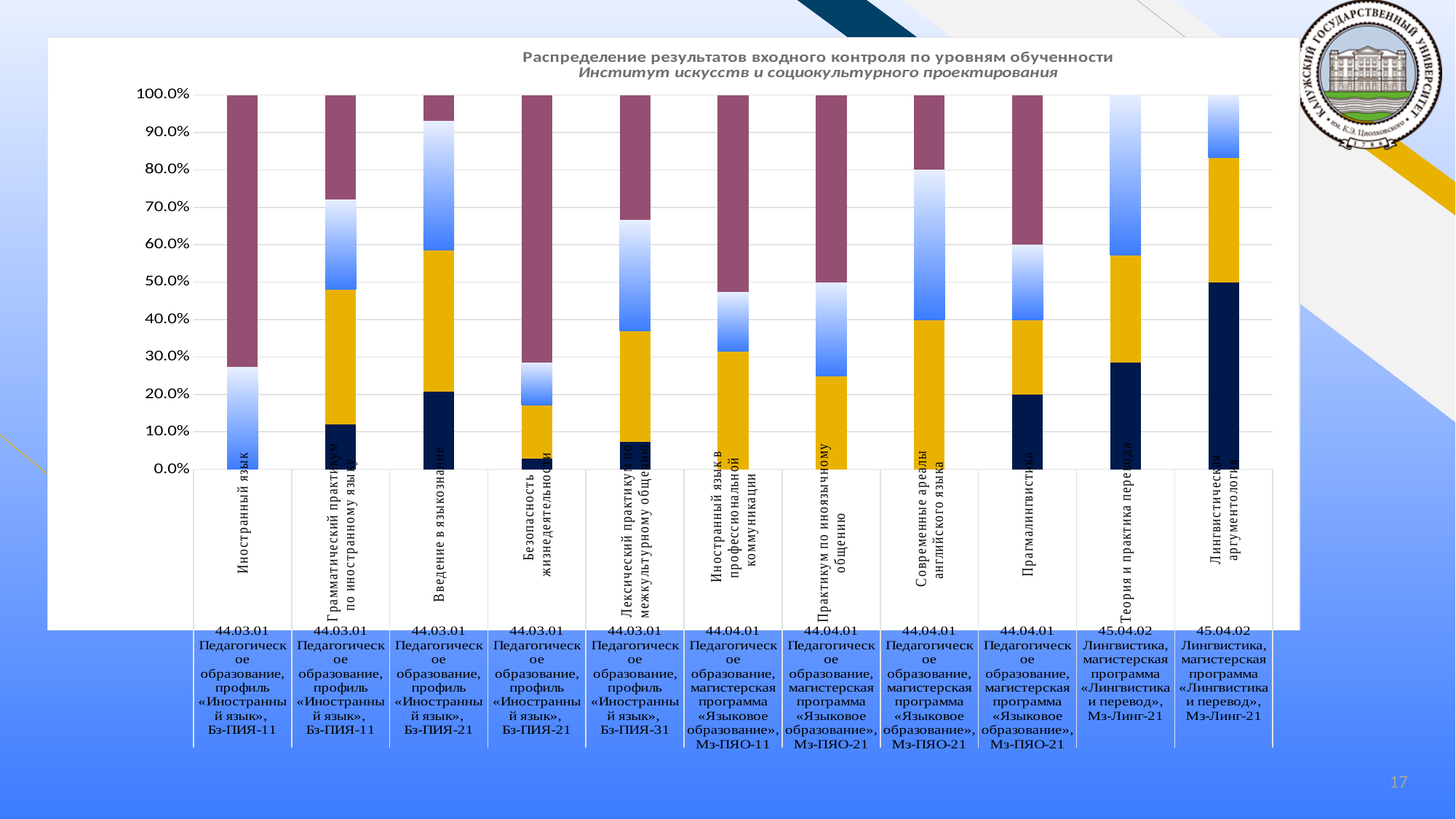
Which discipline has the largest dark navy (bottom) segment? Лингвистическая аргументология How many bars (disciplines) are plotted in the chart? 11 In the bar for Введение в языкознание, is the top of the yellow segment greater or less than 50%? greater Is the dark navy (bottom) segment of the bar for Теория и практика перевода greater or less than 20%? greater What kind of chart is shown on the slide? Stacked bar chart Which bar has the larger purple segment: Безопасность жизнедеятельности or Прагмалингвистика? Безопасность жизнедеятельности Which institute is named in the chart subtitle? Институт искусств и социокультурного проектирования Which bar has the larger yellow segment: Лингвистическая аргументология or Иностранный язык? Лингвистическая аргументология How many bars have no dark navy (bottom) segment? 4 What is the first line of the chart title? Распределение результатов входного контроля по уровням обученности Is the purple (top) segment of the bar for Иностранный язык greater or less than 60% of the bar? greater How many bars have no purple (top) segment at all? 2